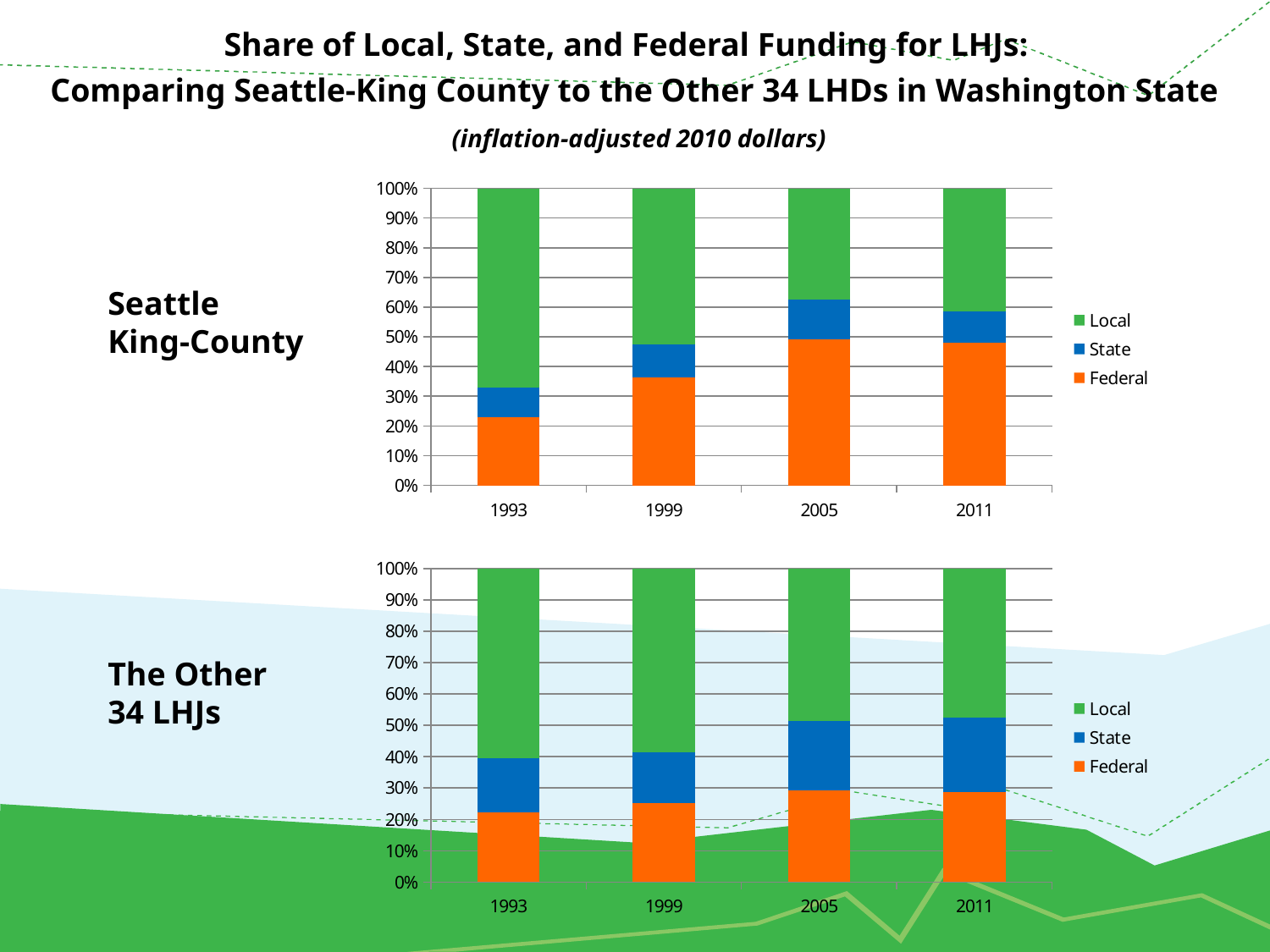
How many series does the legend of The Other 34 LHJs chart list? 3 In the Seattle King-County chart, is the Federal share in 2005 greater or less than 40%? greater In the Seattle King-County chart, is the Federal share in 1993 greater or less than 30%? less In The Other 34 LHJs chart, is the Local share in 1993 greater or less than 50%? greater In The Other 34 LHJs chart, is the Local share larger in 1993 or in 2011? 1993 What kind of chart is the Seattle King-County chart? stacked bar chart In The Other 34 LHJs chart, does the Federal share rise or fall from 1993 to 2005? rise What colour represents Federal funding in the charts? orange What are the three legend entries in the Seattle King-County chart? Local, State, Federal How many years are shown on the x axis of the Seattle King-County chart? 4 In the Seattle King-County chart, which year has the lowest Federal share? 1993 In the Seattle King-County chart, is the Federal share larger in 1993 or in 1999? 1999